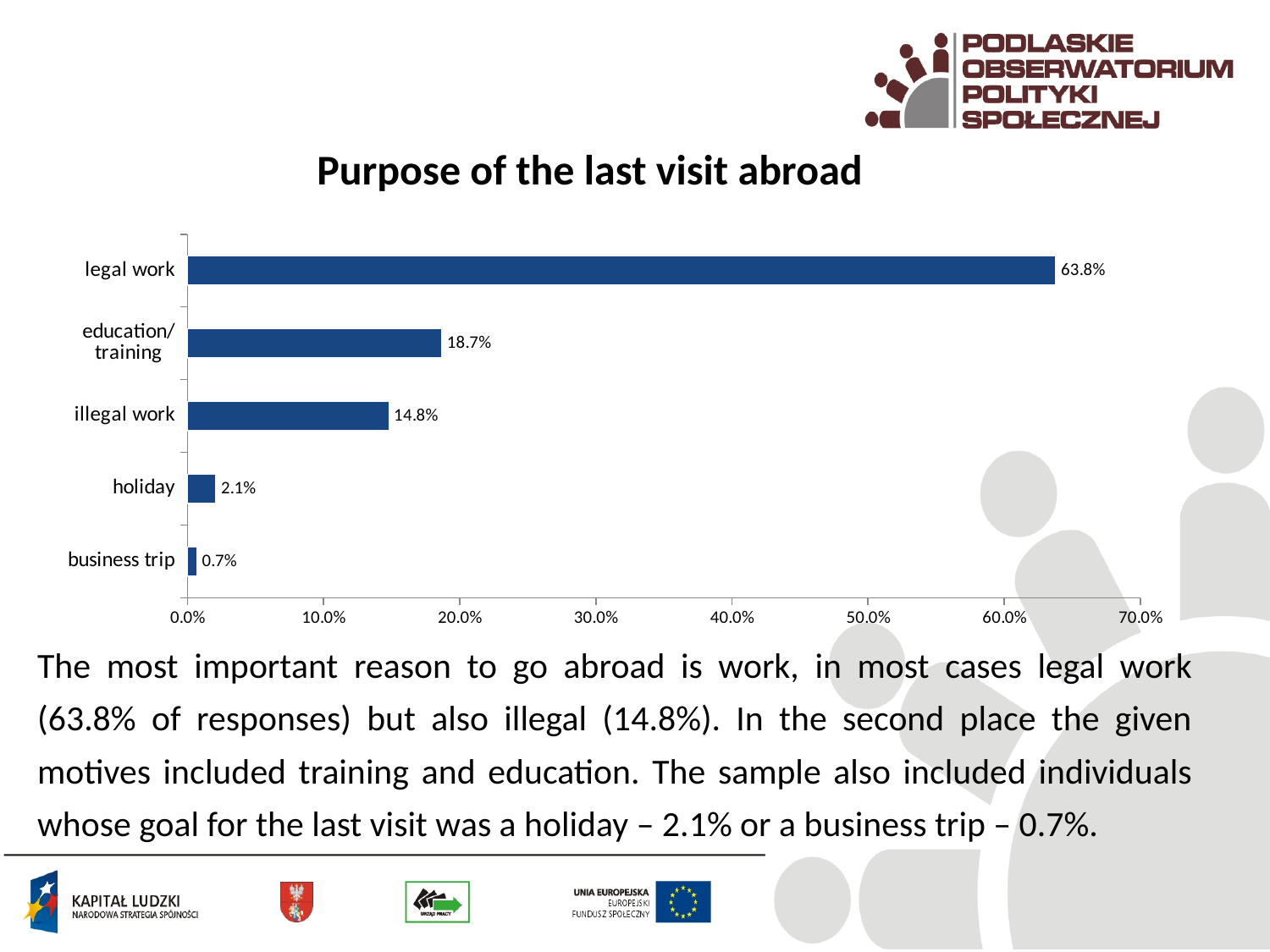
What is the value for business trip? 0.7% What is the value for education/training? 18.7% How many categories are shown in the chart? 5 What is the difference between the values for education/training and illegal work? 3.9% What is the value for holiday? 2.1% What is the value for illegal work? 14.8% Which category has the lowest value? business trip What is the value for legal work? 63.8% What kind of chart is shown on the slide? bar chart What is the difference between the values for legal work and illegal work? 49.0% Which is larger, the value for holiday or the value for business trip? holiday Which category has the highest value? legal work